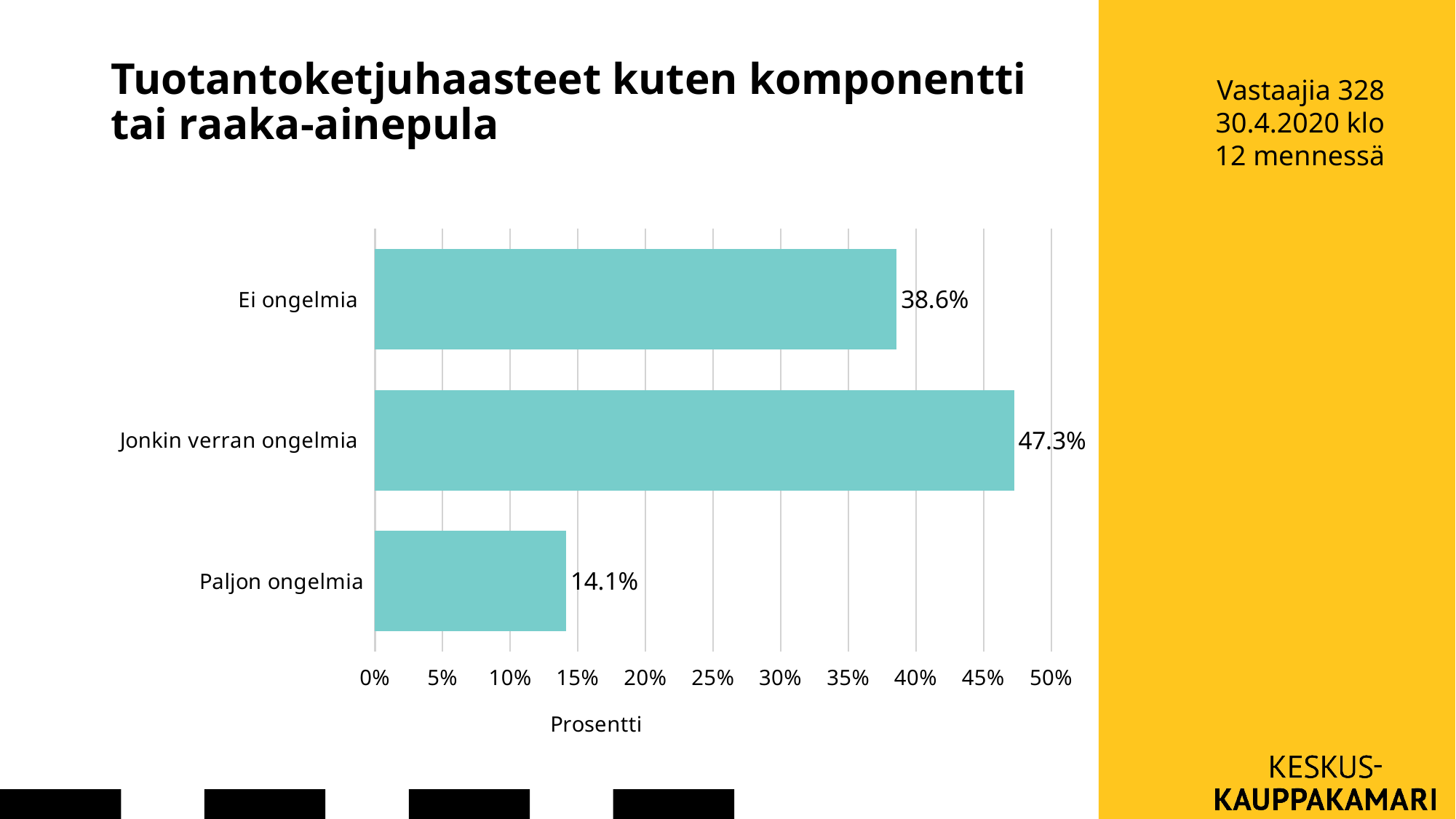
What is the difference between the values for "Jonkin verran ongelmia" and "Ei ongelmia"? 8.7% Which category has the highest value? Jonkin verran ongelmia What is the value for "Paljon ongelmia"? 14.1% What is the difference between the values for "Ei ongelmia" and "Paljon ongelmia"? 24.5% How many categories are shown in the chart? 3 What is the value for "Ei ongelmia"? 38.6% Which is larger, the value for "Ei ongelmia" or the value for "Paljon ongelmia"? Ei ongelmia What kind of chart is shown on the slide? Bar chart What is the value for "Jonkin verran ongelmia"? 47.3% What is the label of the horizontal axis? Prosentti Which category has the lowest value? Paljon ongelmia Is the value for "Jonkin verran ongelmia" greater or less than 45%? greater